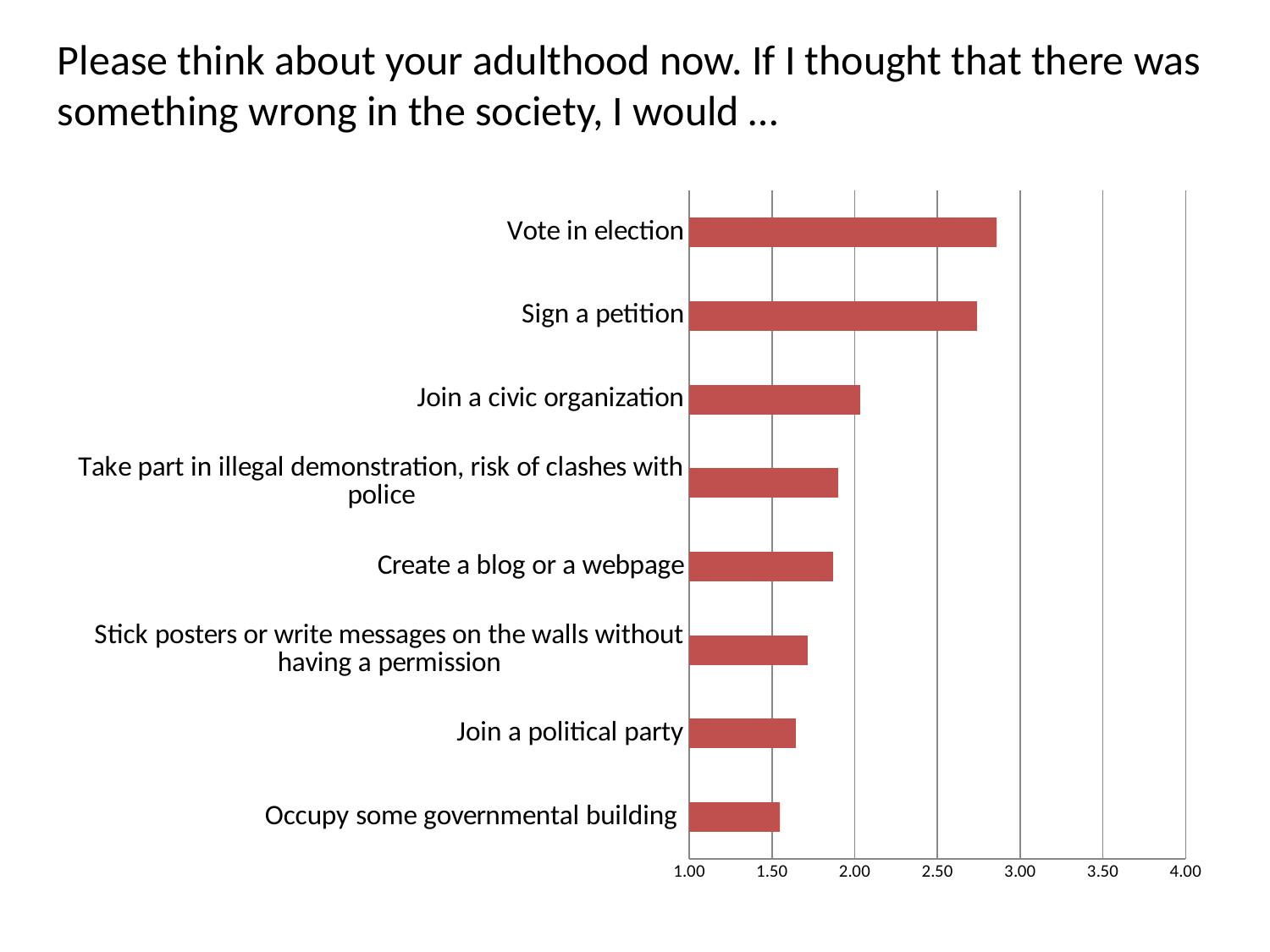
Which has a larger value, Sign a petition or Join a political party? Sign a petition Is the value for Vote in election greater or less than 2.50? greater Do the bar values increase or decrease going from the top category to the bottom category? decrease Is the value for Stick posters or write messages on the walls without having a permission greater or less than 2.00? less Which has a larger value, Vote in election or Join a civic organization? Vote in election Which category has the highest value? Vote in election Is the value for Join a political party greater or less than 1.50? greater How many categories (bars) does the chart show? 8 What kind of chart is shown on the slide? Bar chart Which category has the lowest value? Occupy some governmental building